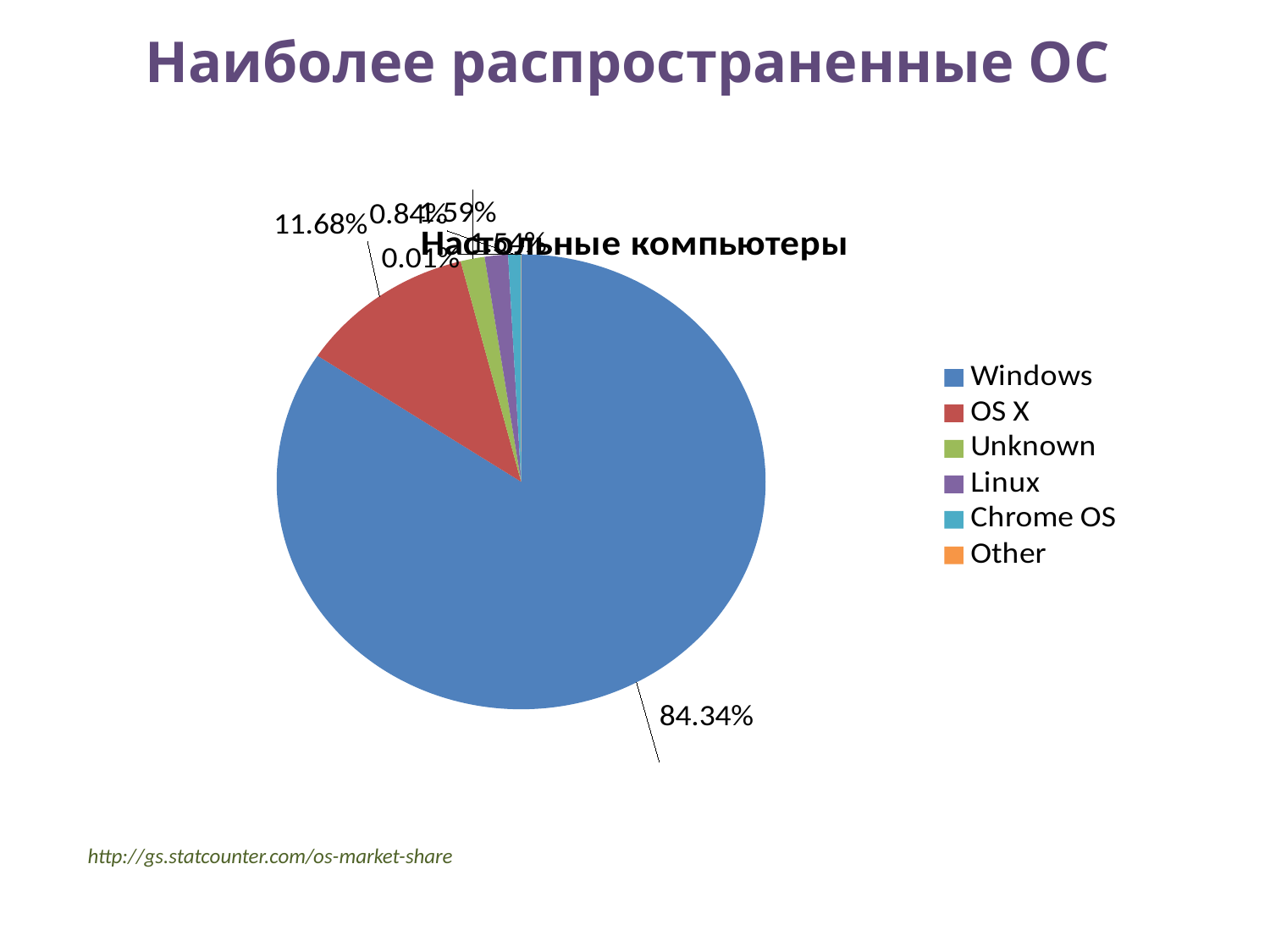
Which slice is larger, Windows or OS X? Windows What is the title of the chart? Настольные компьютеры What share of the pie does OS X have? 11.68% What is the combined share of Windows and OS X? 96.02% What share of the pie does Windows have? 84.34% Which operating system has the largest slice of the pie? Windows What is the difference between the Windows share and the OS X share? 72.66% How many operating systems are listed in the legend? 6 What kind of chart is shown on the slide? Pie chart What colour is the Windows slice? Blue